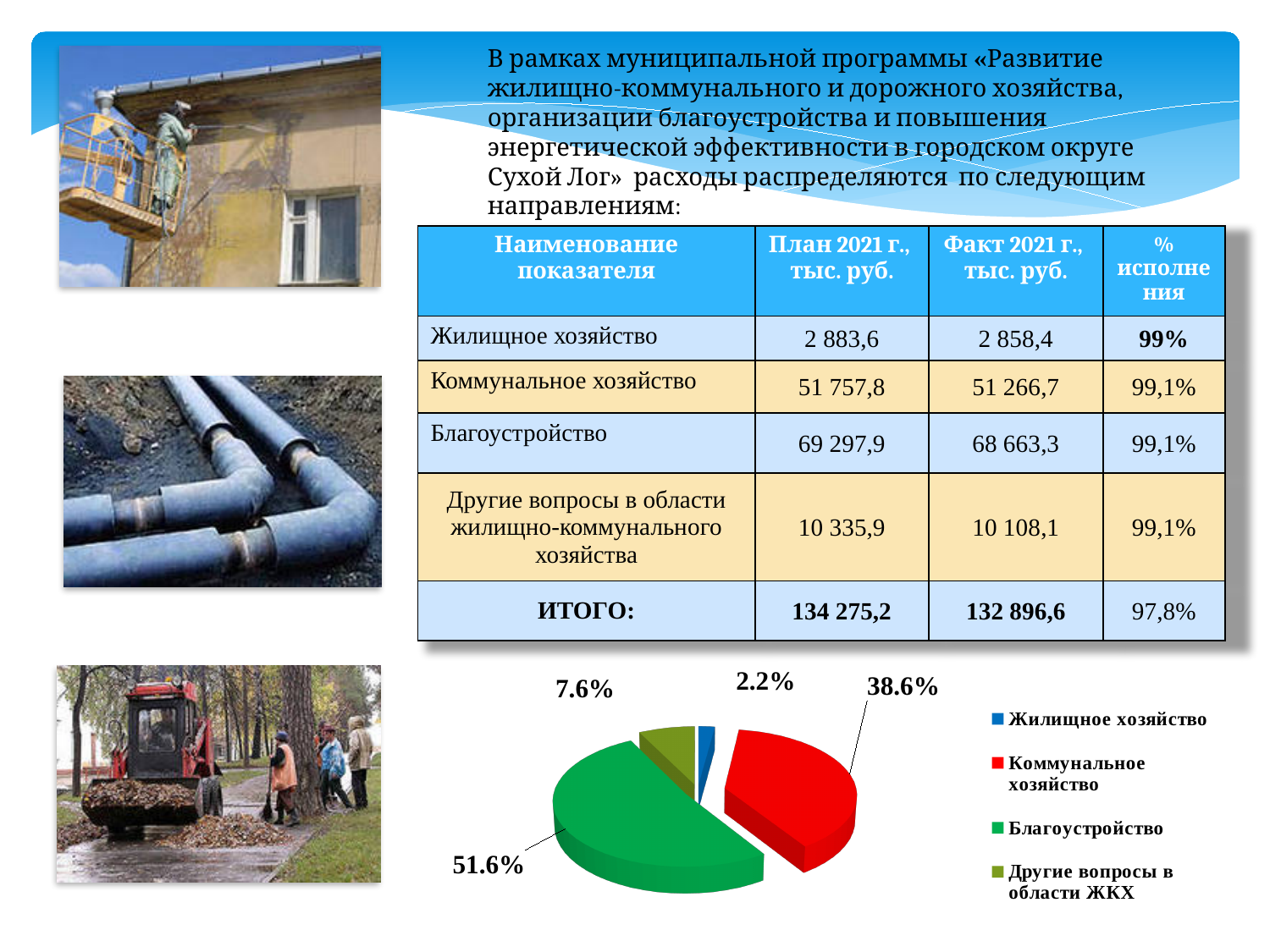
In the pie chart, what share is shown for Коммунальное хозяйство? 38.6% How many entries does the pie chart legend list? 4 What colour is the Благоустройство slice in the pie chart? Green Which category has the smallest slice in the pie chart? Жилищное хозяйство In the pie chart, what share is shown for Другие вопросы в области ЖКХ? 7.6% What kind of chart is shown at the bottom of the slide? Pie chart In the pie chart, which is larger: the slice for Коммунальное хозяйство or the slice for Другие вопросы в области ЖКХ? Коммунальное хозяйство Which category has the largest slice in the pie chart? Благоустройство In the pie chart, what share is shown for Благоустройство? 51.6% In the pie chart, what is the difference in percentage points between the Благоустройство slice and the Коммунальное хозяйство slice? 13 percentage points How many slices does the pie chart have? 4